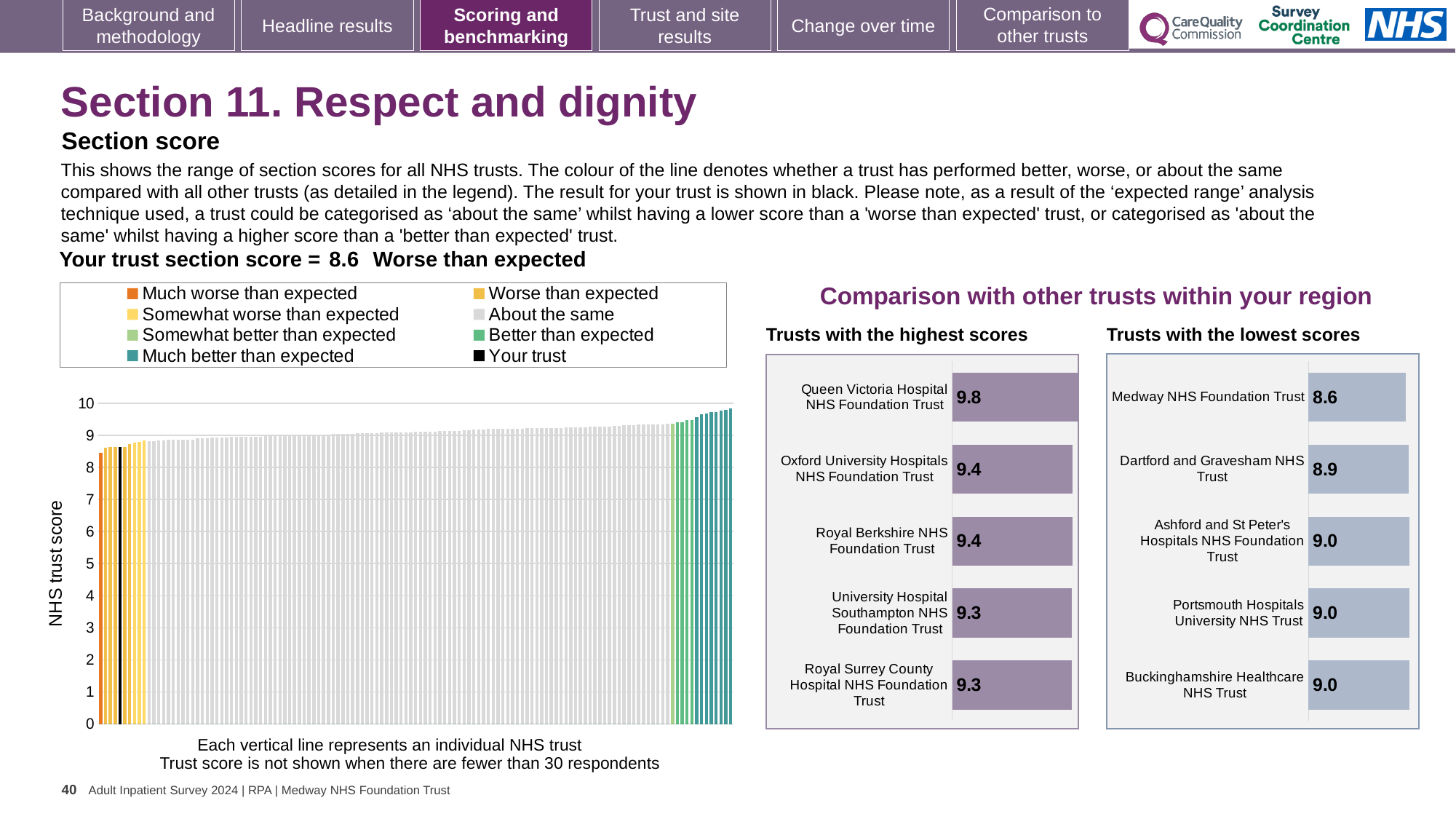
How many trusts are listed in the 'Trusts with the highest scores' chart? 5 In the 'Trusts with the lowest scores' chart, which has the higher score: Medway NHS Foundation Trust or Dartford and Gravesham NHS Trust? Dartford and Gravesham NHS Trust In the main chart on the left showing all NHS trusts, is the value for 'Your trust' (the black bar) greater or less than 9? less In the 'Trusts with the lowest scores' chart, what is the score for Dartford and Gravesham NHS Trust? 8.9 How many entries does the legend of the main chart on the left list? 8 How many trusts are listed in the 'Trusts with the lowest scores' chart? 5 In the 'Trusts with the lowest scores' chart, what is the difference between the scores of Portsmouth Hospitals University NHS Trust and Medway NHS Foundation Trust? 0.4 What kind of chart is the 'Trusts with the highest scores' chart? bar chart In the 'Trusts with the highest scores' chart, what is the difference between the scores of Queen Victoria Hospital NHS Foundation Trust and Royal Surrey County Hospital NHS Foundation Trust? 0.5 In the 'Trusts with the highest scores' chart, which trust has the highest score? Queen Victoria Hospital NHS Foundation Trust In the 'Trusts with the highest scores' chart, what is the score for Queen Victoria Hospital NHS Foundation Trust? 9.8 In the 'Trusts with the lowest scores' chart, which trust has the lowest score? Medway NHS Foundation Trust